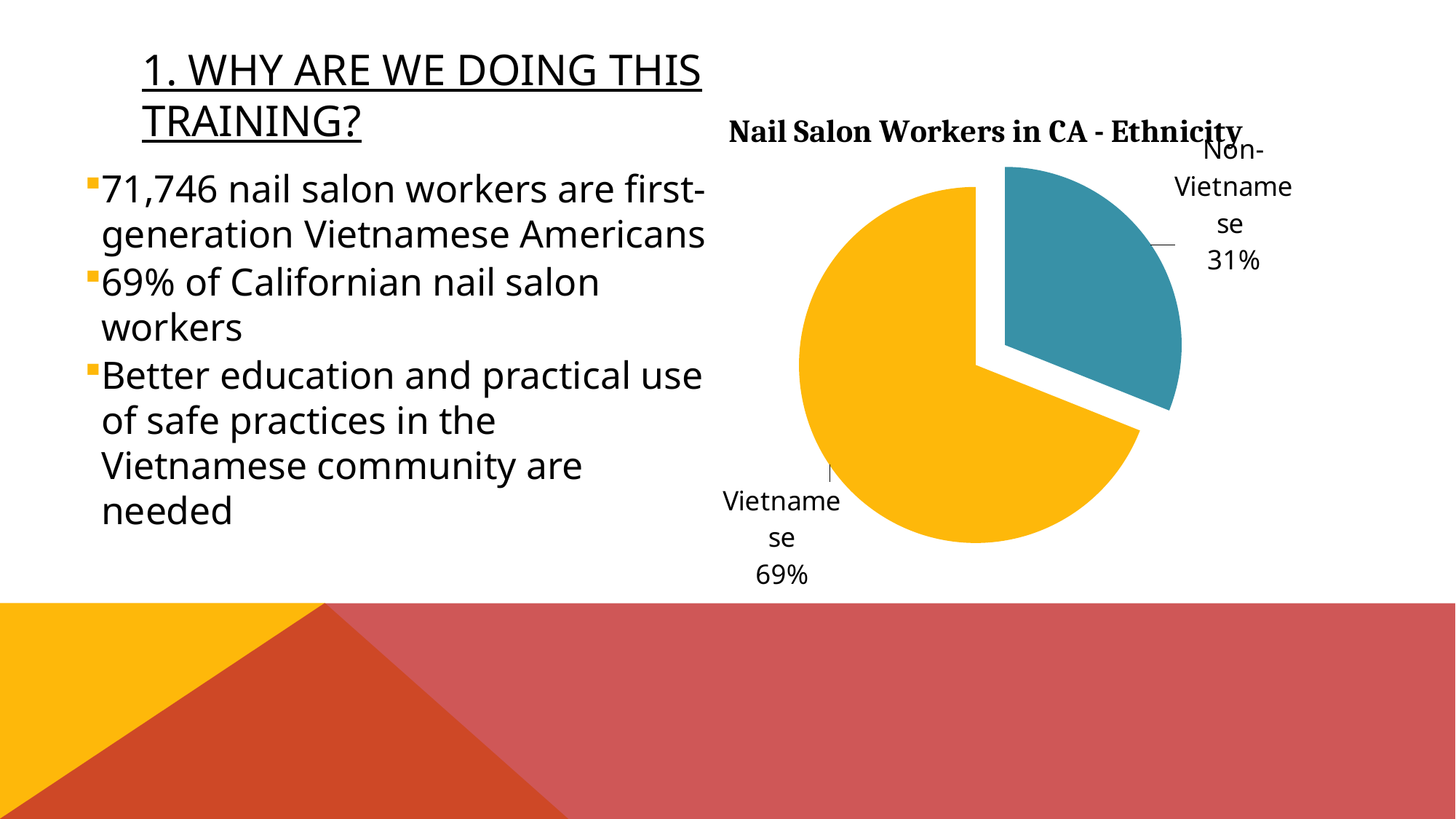
What share of the pie is labelled Non-Vietnamese? 31% What colour is the Vietnamese slice of the pie? yellow What is the title of the chart? Nail Salon Workers in CA - Ethnicity How many slices does the pie chart have? 2 What is the total of the two slice percentages shown on the pie? 100% What kind of chart is shown on the slide? pie chart What share of the pie is labelled Vietnamese? 69% What is the difference in percentage points between the Vietnamese and Non-Vietnamese slices? 38 Which slice of the pie is the smallest? Non-Vietnamese Which slice of the pie is the largest? Vietnamese Which is larger, the Vietnamese slice or the Non-Vietnamese slice? Vietnamese